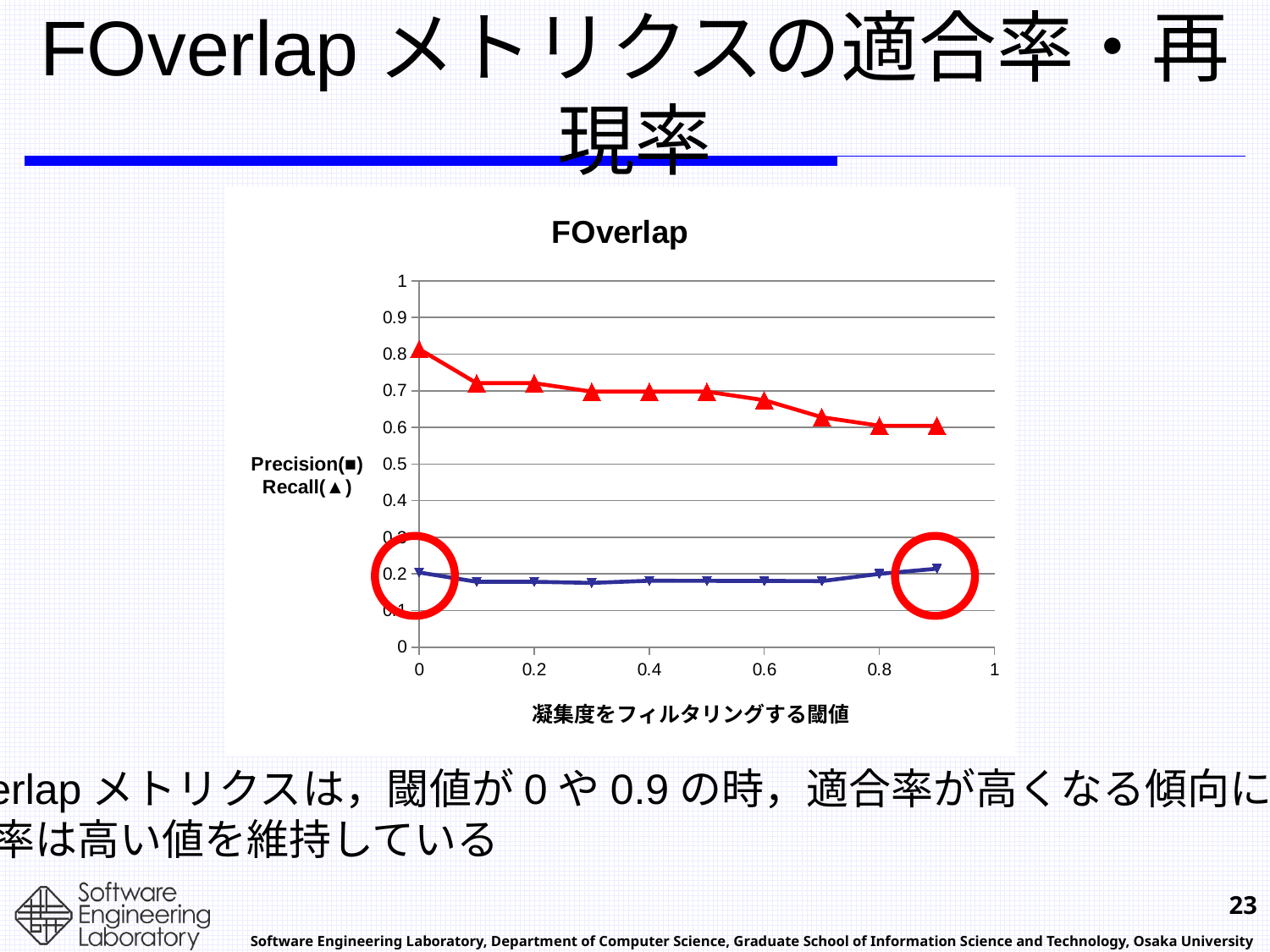
Does the Recall series rise or fall as the threshold on the x axis increases? fall Is the Recall value at threshold 0.9 greater or less than 0.7? less Is the Precision value at threshold 0.4 greater or less than 0.3? less How many series does the chart plot? 2 At a threshold of 0.5, which series has the higher value, Precision or Recall? Recall At which threshold value is Recall highest? 0 What kind of chart is shown on the slide? line chart What is the title of the chart? FOverlap How many data points does the Recall series have? 10 Is the Recall value at threshold 0 greater or less than 0.7? greater Which series is drawn in red with triangle markers? Recall